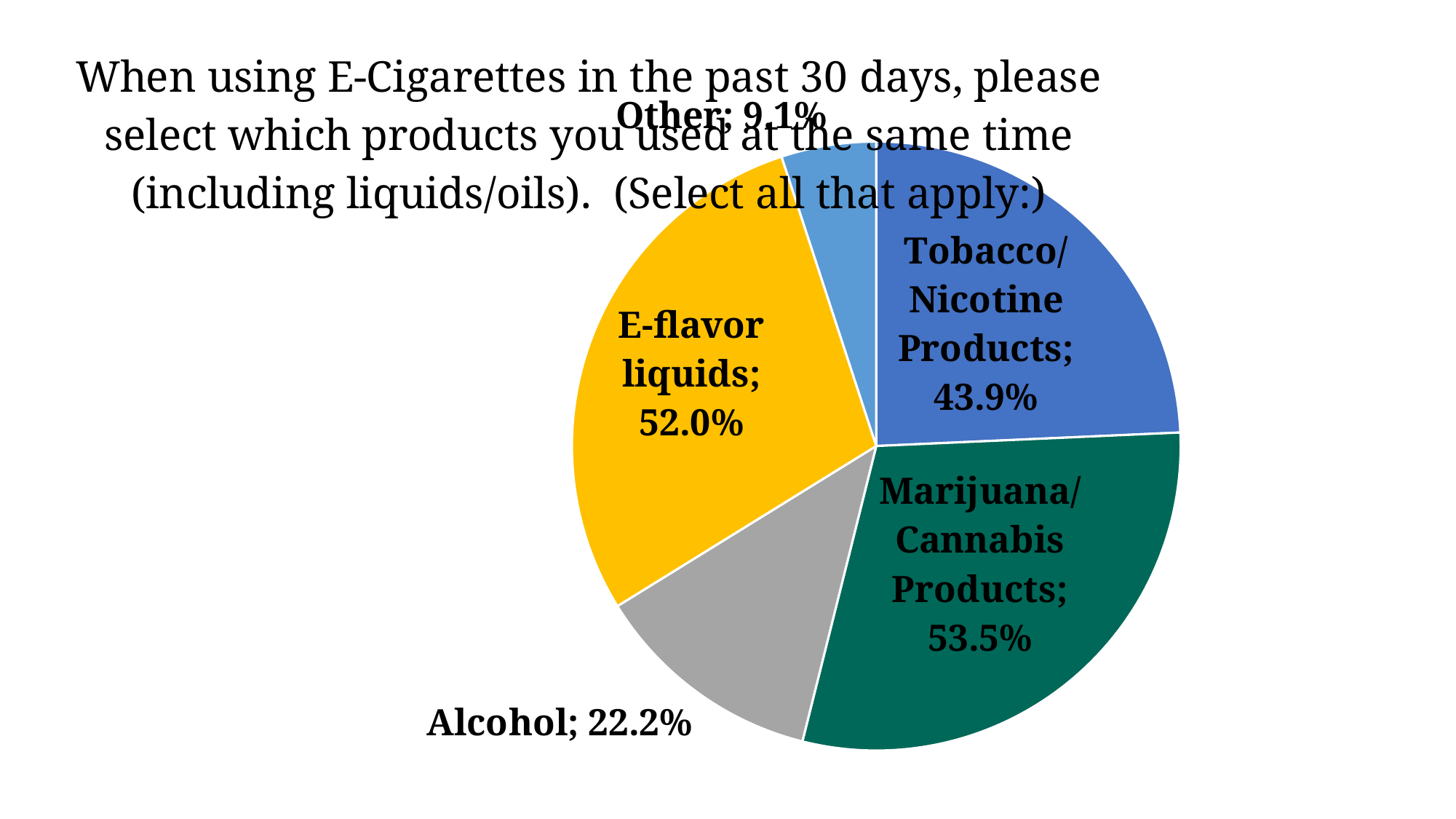
What value is shown for Tobacco/Nicotine Products? 43.9% What value is shown for Other? 9.1% What value is shown for Marijuana/Cannabis Products? 53.5% What value is shown for Alcohol? 22.2% What kind of chart is shown on the slide? Pie chart Which is larger, the value for Alcohol or the value for Other? Alcohol How many slices does the pie chart have? 5 Which category has the highest value? Marijuana/Cannabis Products What value is shown for E-flavor liquids? 52.0% What colour is the E-flavor liquids slice? Yellow Which category has the lowest value? Other What is the difference between the values for Marijuana/Cannabis Products and Tobacco/Nicotine Products? 9.6 percentage points